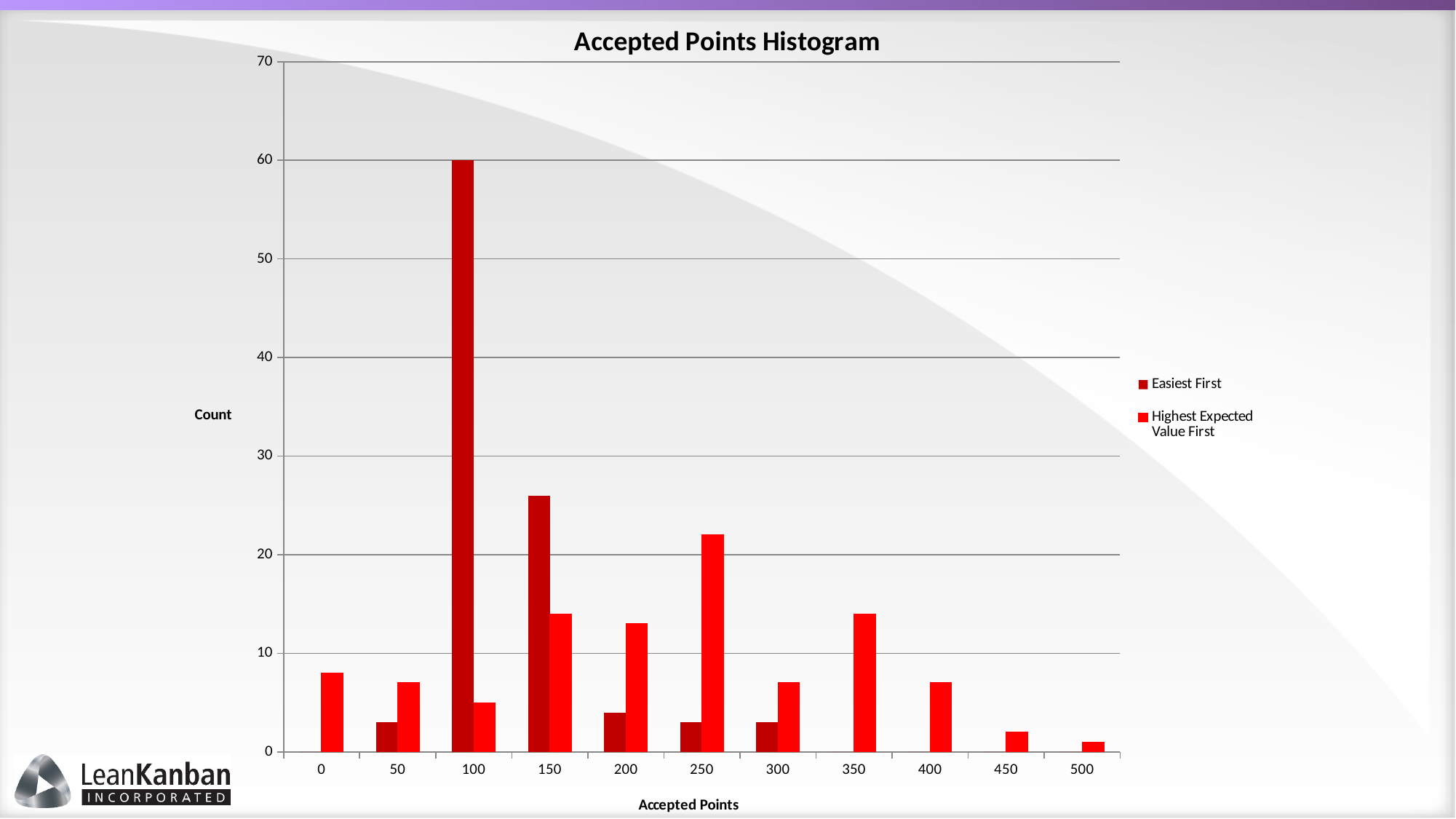
What kind of chart is the Accepted Points Histogram? bar chart How many series does the legend list? 2 What is the Count for Easiest First at 100 Accepted Points? 60 At which Accepted Points value is the Highest Expected Value First series lowest? 500 At which Accepted Points value is the Easiest First series highest? 100 Is the Count for Highest Expected Value First at 0 Accepted Points greater or less than 10? less How many categories are shown on the x axis? 11 Is the Count for Easiest First at 150 Accepted Points greater or less than 20? greater At which Accepted Points value is the Highest Expected Value First series highest? 250 What is the label of the vertical axis? Count Is the Count for Highest Expected Value First at 250 Accepted Points greater or less than 30? less At 150 Accepted Points, which series has the larger Count, Easiest First or Highest Expected Value First? Easiest First